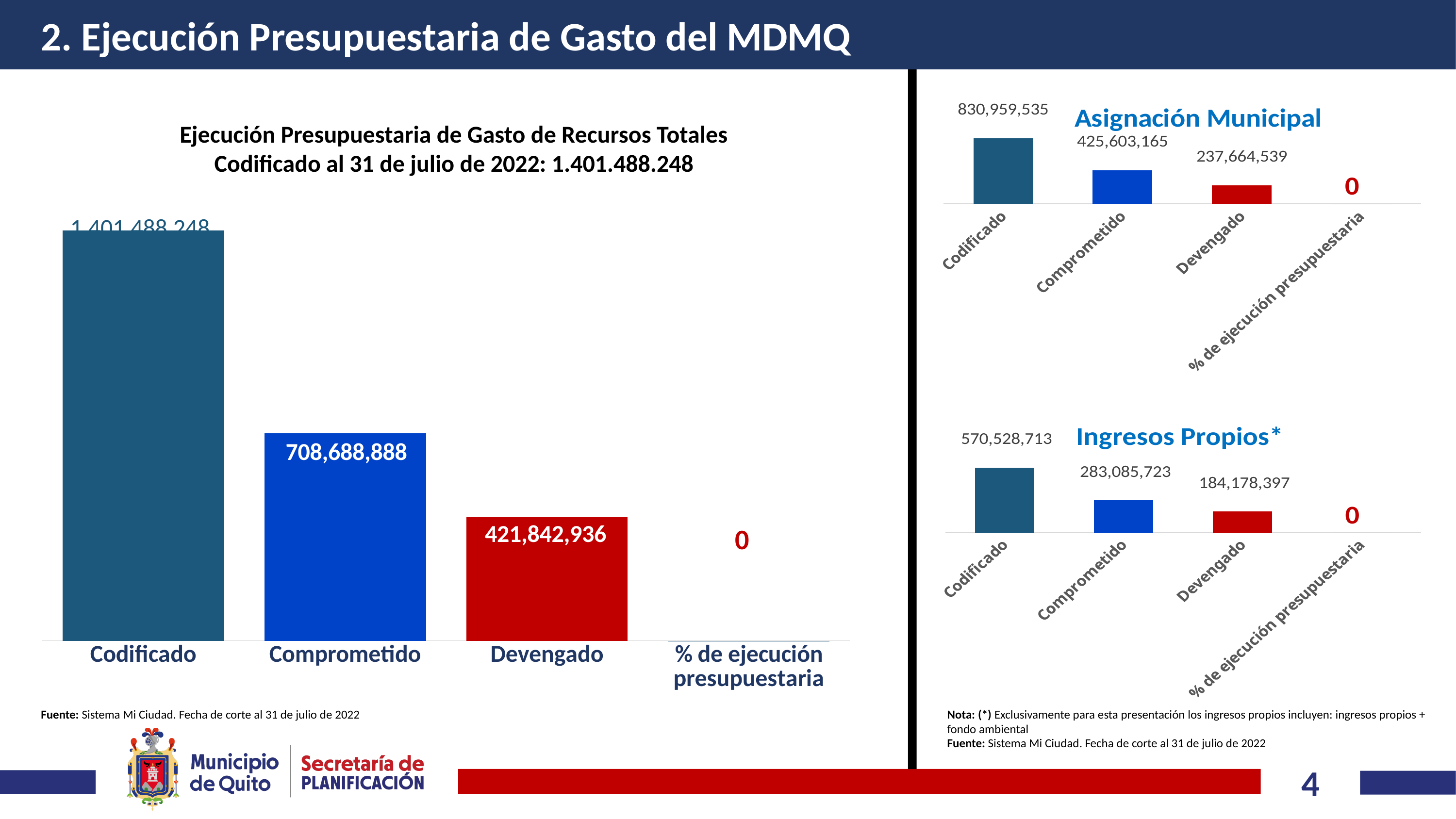
In the 'Asignación Municipal' chart, what is the difference between Comprometido and Devengado? 187,938,626 What kind of chart is the 'Asignación Municipal' chart? Bar chart In the 'Asignación Municipal' chart, what is the value for Devengado? 237,664,539 In the 'Ejecución Presupuestaria de Gasto de Recursos Totales' chart on the left, what is the value for Comprometido? 708,688,888 In the 'Ingresos Propios*' chart, which is larger, Codificado or Devengado? Codificado In the 'Ejecución Presupuestaria de Gasto de Recursos Totales' chart on the left, what is the difference between Comprometido and Devengado? 286,845,952 In the 'Ingresos Propios*' chart, what is the difference between Codificado and Comprometido? 287,442,990 In the 'Ejecución Presupuestaria de Gasto de Recursos Totales' chart on the left, how many categories are shown on the x axis? 4 In the 'Ejecución Presupuestaria de Gasto de Recursos Totales' chart on the left, which category has the highest value? Codificado In the 'Asignación Municipal' chart, what is the value for Codificado? 830,959,535 In the 'Ingresos Propios*' chart, what is the value for Comprometido? 283,085,723 In the 'Ejecución Presupuestaria de Gasto de Recursos Totales' chart on the left, what is the value for Devengado? 421,842,936